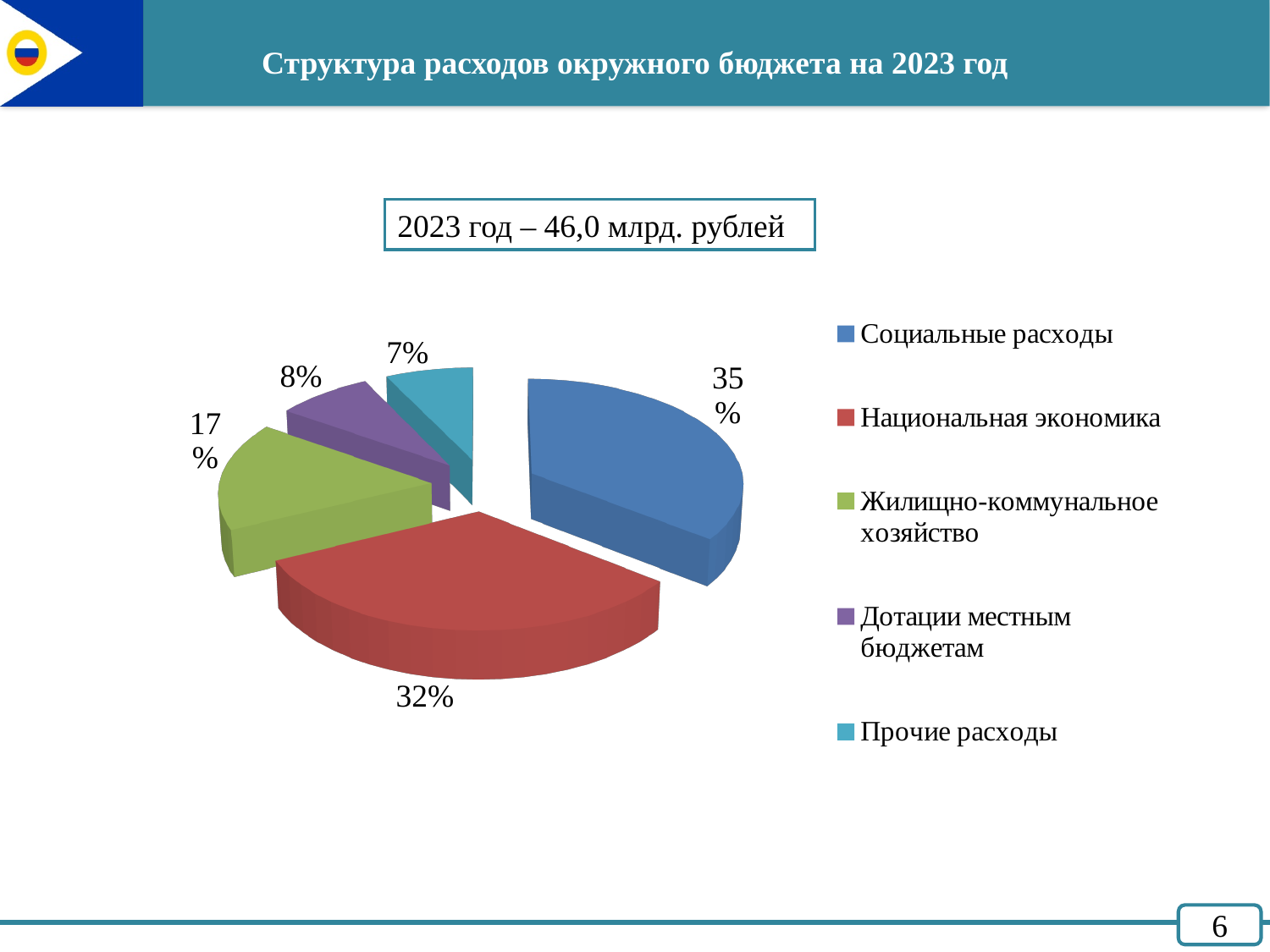
What share of the pie does Прочие расходы have? 7% How many categories does the pie chart show? 5 Which category has the smallest share of the pie? Прочие расходы What share of the pie does Жилищно-коммунальное хозяйство have? 17% Which category has the largest share of the pie? Социальные расходы What share of the pie does Национальная экономика have? 32% What is the difference in percentage points between Социальные расходы and Национальная экономика? 3 What kind of chart is shown on the slide? Pie chart What total budget amount for 2023 is stated above the chart? 46,0 млрд. рублей What share of the pie does Социальные расходы have? 35% Which is larger, the share for Жилищно-коммунальное хозяйство or the share for Дотации местным бюджетам? Жилищно-коммунальное хозяйство What share of the pie does Дотации местным бюджетам have? 8%